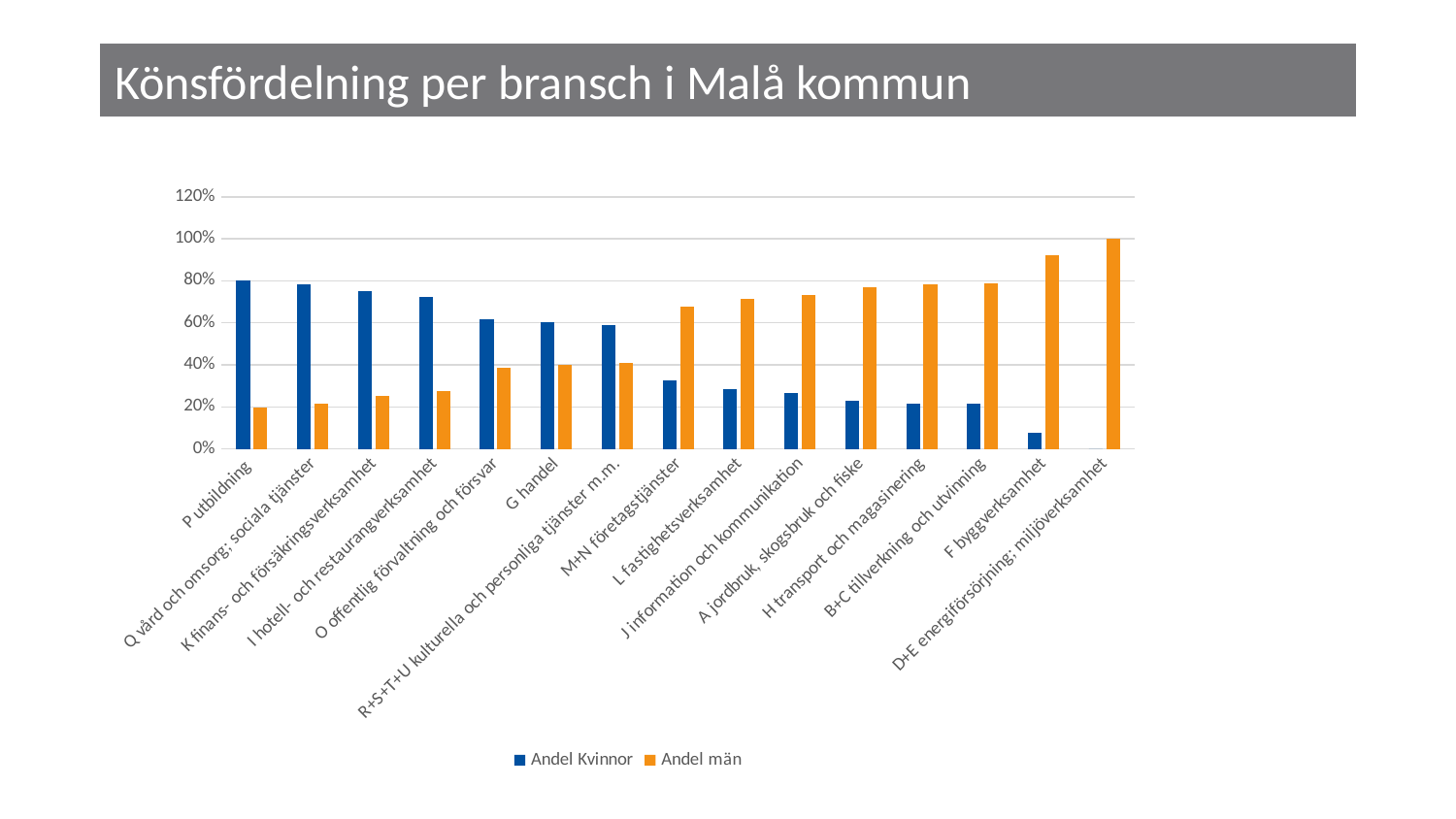
Is the Andel män value for A jordbruk, skogsbruk och fiske greater or less than 60%? greater Do the Andel Kvinnor values rise or fall from left to right along the x axis? fall What is the title of the chart? Könsfördelning per bransch i Malå kommun Which category has the highest value for Andel män? D+E energiförsörjning; miljöverksamhet Do the Andel män values rise or fall from left to right along the x axis? rise For G handel, which is larger: Andel Kvinnor or Andel män? Andel Kvinnor How many series does the legend list? 2 What kind of chart is shown on the slide? bar chart For M+N företagstjänster, which is larger: Andel Kvinnor or Andel män? Andel män Which category has the lowest value for Andel Kvinnor? D+E energiförsörjning; miljöverksamhet How many industry categories are shown on the x axis? 15 Is the Andel Kvinnor value for F byggverksamhet greater or less than 20%? less